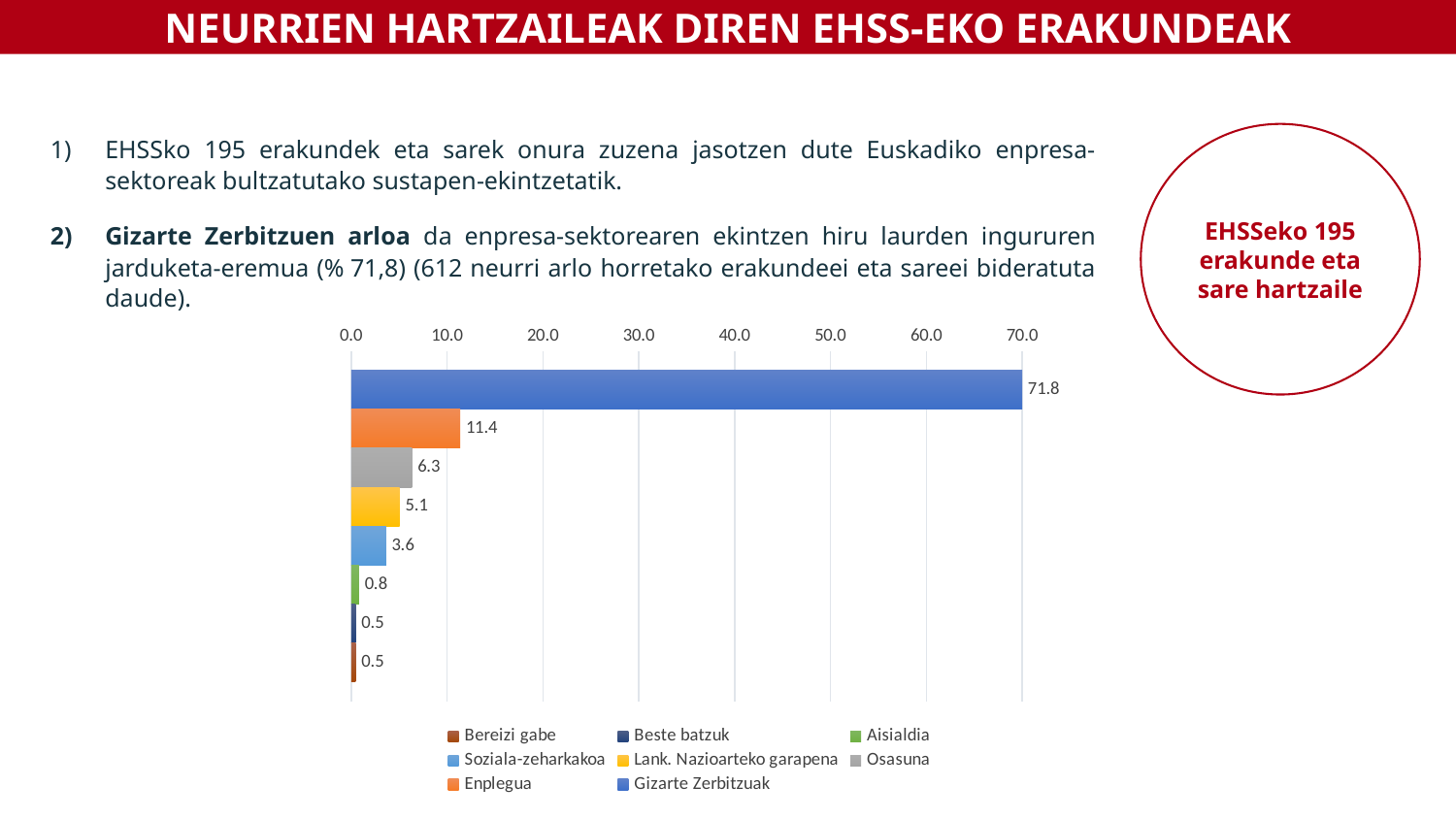
What is the value for Enplegua? 11.4 What is the difference between the values for Gizarte Zerbitzuak and Enplegua? 60.4 What is the value for Osasuna? 6.3 Is the value for Gizarte Zerbitzuak greater or less than 70.0? greater What is the value for Gizarte Zerbitzuak? 71.8 What kind of chart is shown on the slide? bar chart What is the value for Soziala-zeharkakoa? 3.6 How many entries does the legend list? 8 Which category has the highest value? Gizarte Zerbitzuak How many bars are plotted in the chart? 8 Which is larger, the value for Osasuna or the value for Aisialdia? Osasuna What is the value for Lank. Nazioarteko garapena? 5.1